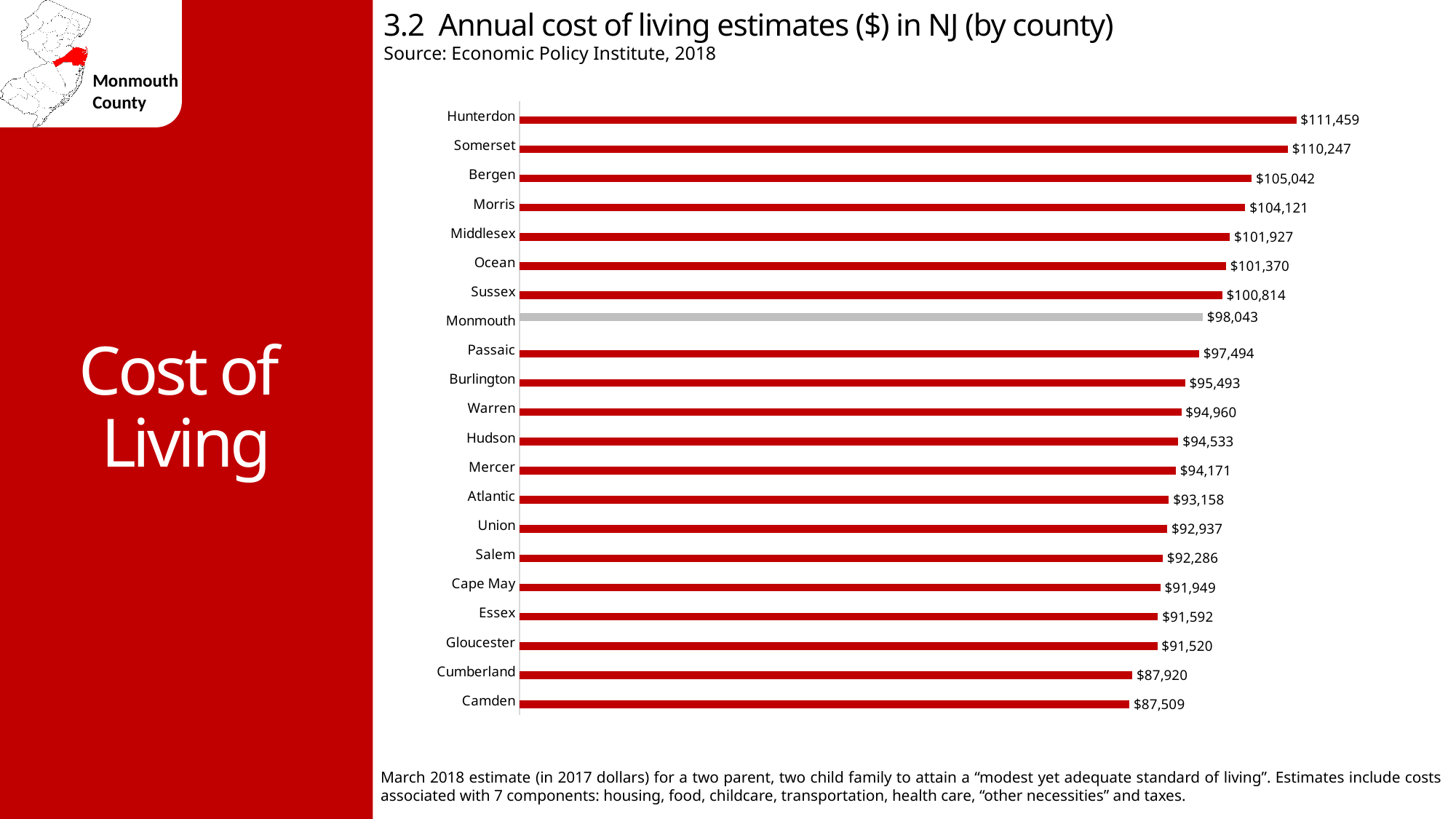
How many counties are shown in the chart? 21 What is the annual cost of living estimate for Cape May County? $91,949 What is the annual cost of living estimate for Bergen County? $105,042 What is the difference between the cost of living estimates for Monmouth and Passaic? $549 Which county has a higher cost of living estimate, Morris or Middlesex? Morris What is the annual cost of living estimate for Monmouth County? $98,043 Which county has the highest annual cost of living estimate? Hunterdon Which county has a higher cost of living estimate, Cumberland or Essex? Essex What type of chart is used to show the annual cost of living estimates? Bar chart What is the difference between the cost of living estimates for Hunterdon and Camden? $23,950 Which county has the lowest annual cost of living estimate? Camden Which county's bar is shown in gray instead of red? Monmouth